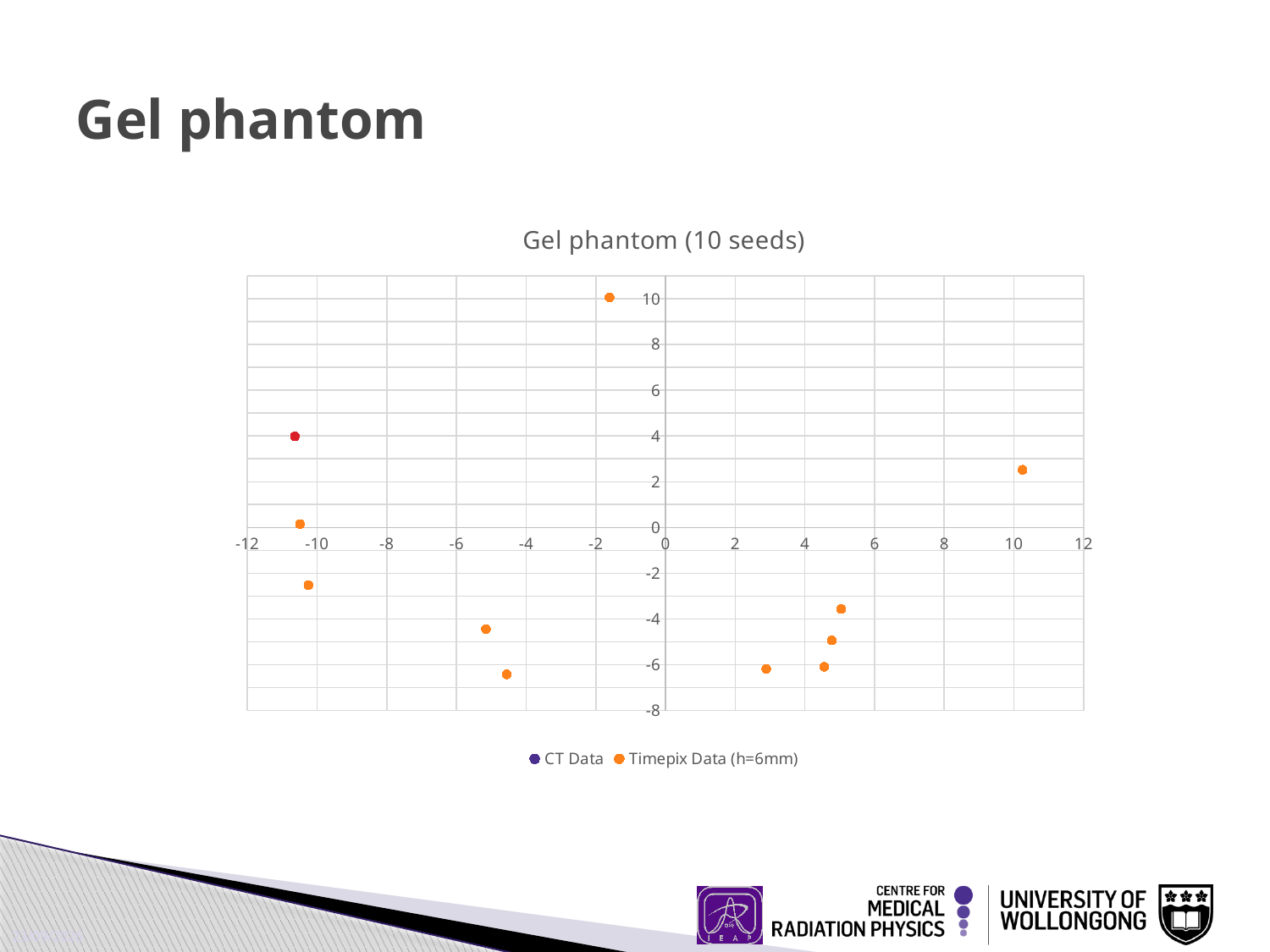
How many series does the chart legend list? 2 Is the y value of the lowest plotted point greater or less than -4? less Which has the larger y value: the topmost point near x = -2 or the point near x = 10? the point near x = -2 Is the y value of the rightmost plotted point greater or less than 0? greater Are there more plotted points below the horizontal axis (y less than 0) or above it? below Is the y value of the topmost plotted point greater or less than 8? greater What are the two series named in the chart legend? CT Data and Timepix Data (h=6mm) What kind of chart is shown on the slide? scatter chart What is the title of the chart? Gel phantom (10 seeds)